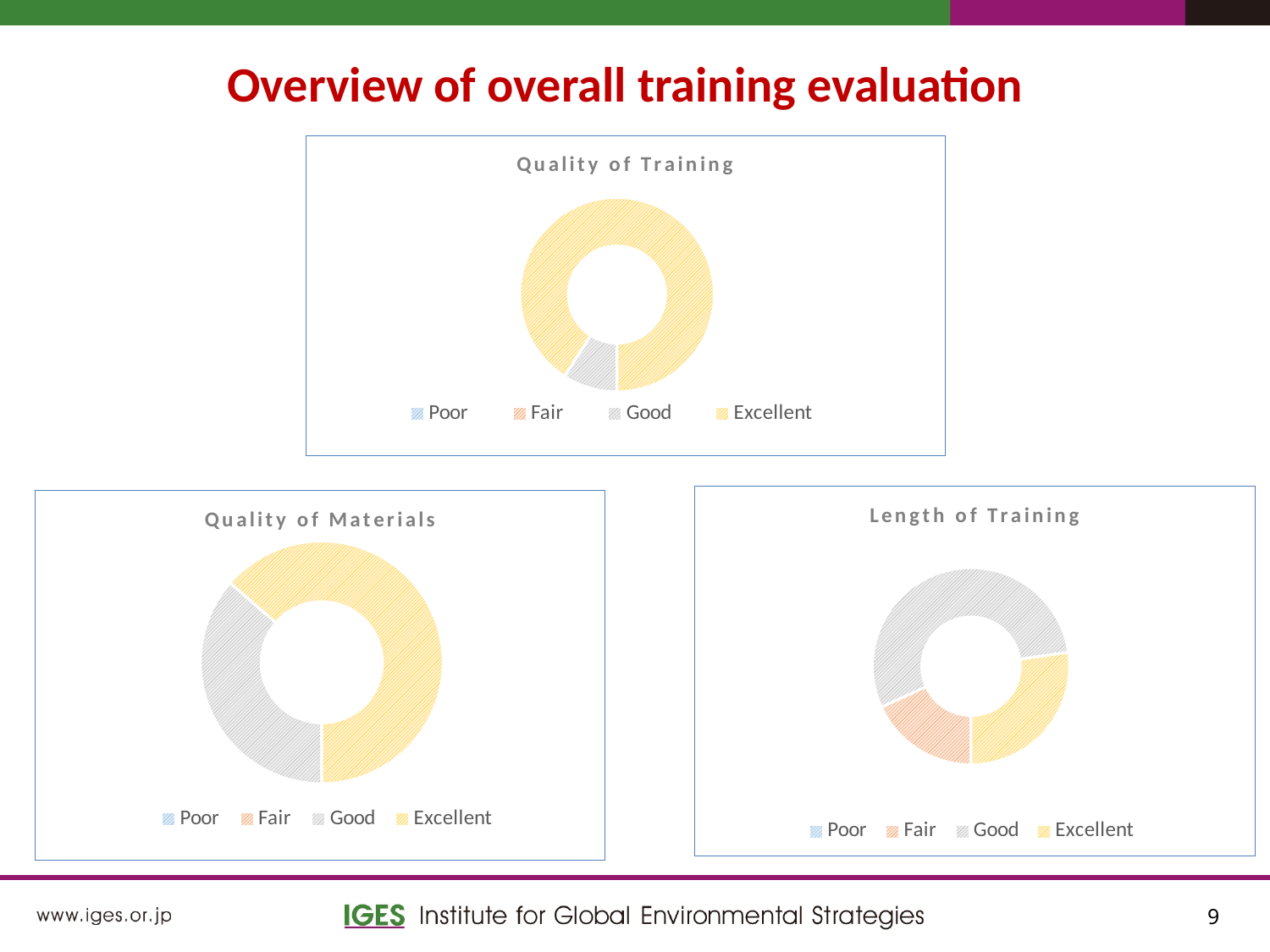
In the "Quality of Materials" chart, which category has the largest share? Excellent In the "Length of Training" chart, which is larger, the Fair slice or the Excellent slice? Excellent In the "Quality of Training" chart, is the Excellent share greater or less than 50%? greater How many categories does the legend of the "Quality of Training" chart list? 4 In the "Length of Training" chart, which of the visible slices is the smallest? Fair How many charts are shown on the slide? 3 In the "Quality of Training" chart, which category other than Excellent has a visible slice? Good In the "Length of Training" chart, which category has the largest share? Good In the "Quality of Materials" chart, which is larger, the Good slice or the Excellent slice? Excellent In the "Quality of Training" chart, which category has the largest share? Excellent What is the title of the chart at the bottom right of the slide? Length of Training What kind of chart is the "Quality of Training" chart? Doughnut chart